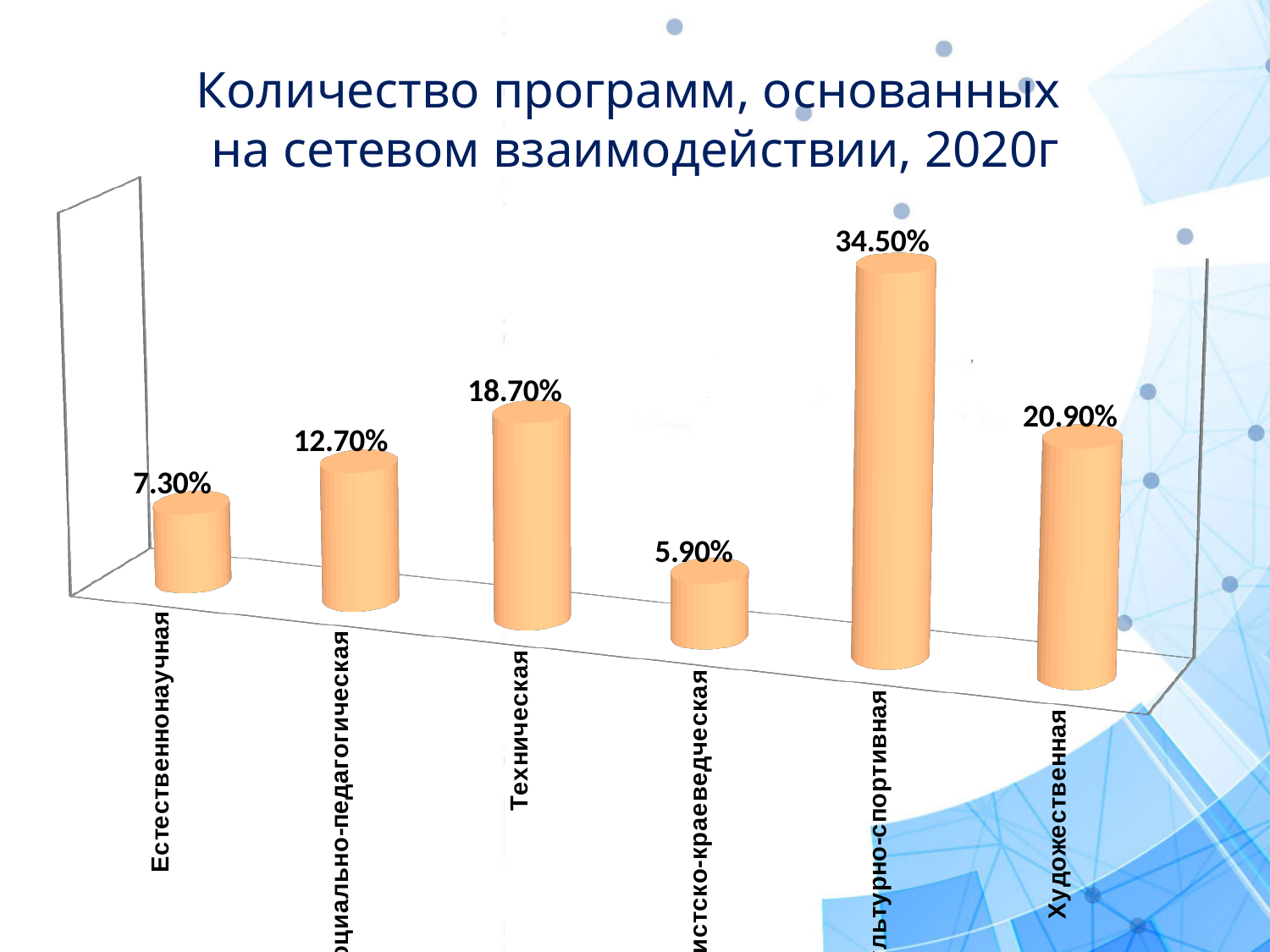
What is the difference between the values for Техническая and Естественнонаучная? 11.40% Which is larger, the value for Техническая or the value for Художественная? Художественная What is the title of the chart? Количество программ, основанных на сетевом взаимодействии, 2020г What is the value for Художественная? 20.90% What is the value for Естественнонаучная? 7.30% What is the value for Техническая? 18.70% What is the highest value shown on the chart? 34.50% What is the difference between the highest and lowest values on the chart? 28.60% What is the difference between the values for Художественная and Техническая? 2.20% How many categories are shown on the chart? 6 What kind of chart is shown on the slide? Bar chart What is the lowest value shown on the chart? 5.90%